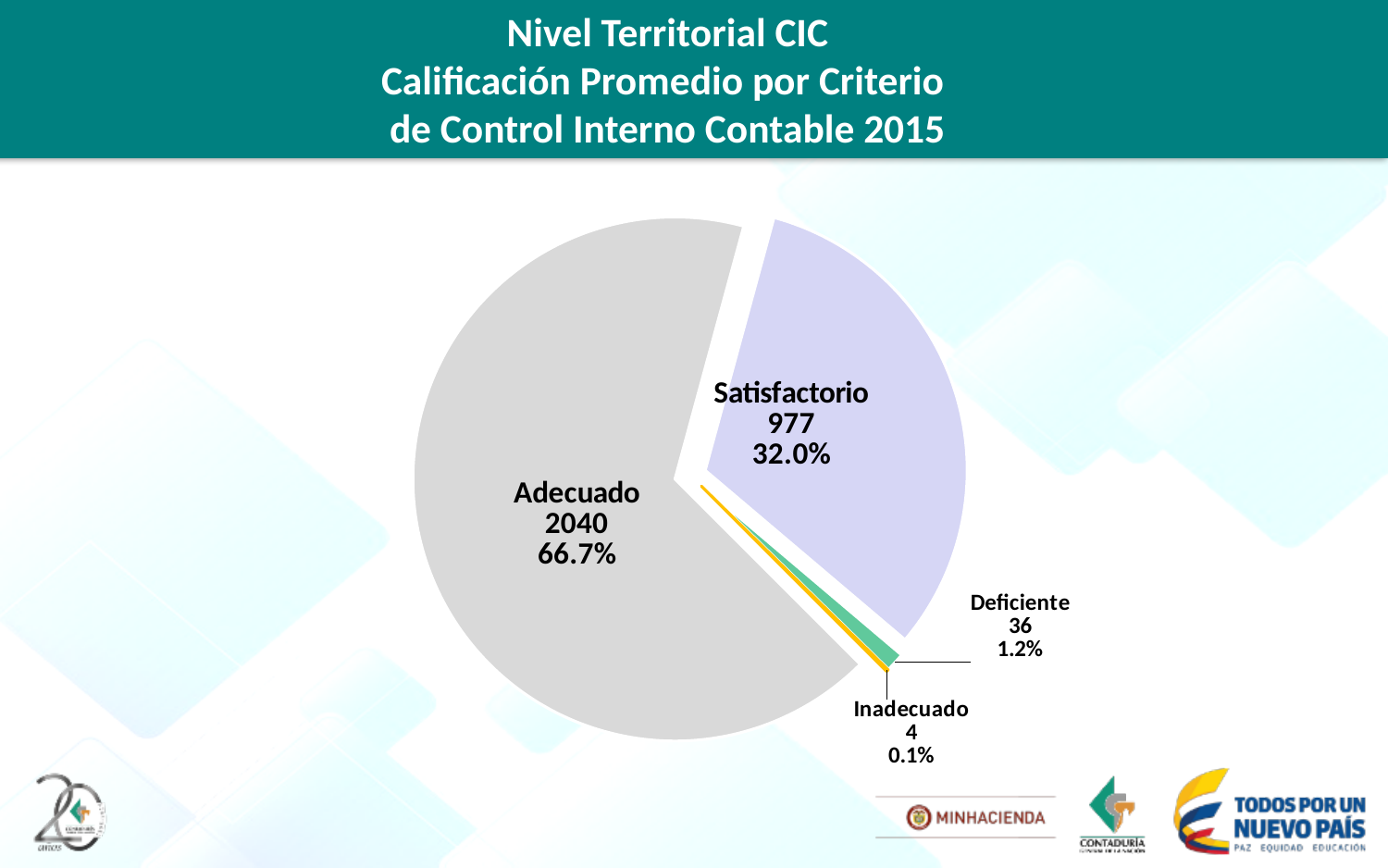
What is the difference between the values for Adecuado and Satisfactorio? 1063 What is the value shown for Satisfactorio? 977 What is the value shown for Deficiente? 36 Which category has the smallest slice? Inadecuado What is the value shown for Adecuado? 2040 What is the value shown for Inadecuado? 4 What share of the pie does Satisfactorio represent? 32.0% Which is larger, the value for Deficiente or the value for Inadecuado? Deficiente Which category has the largest slice? Adecuado How many slices does the pie chart have? 4 What share of the pie does Adecuado represent? 66.7% What kind of chart is shown on the slide? pie chart